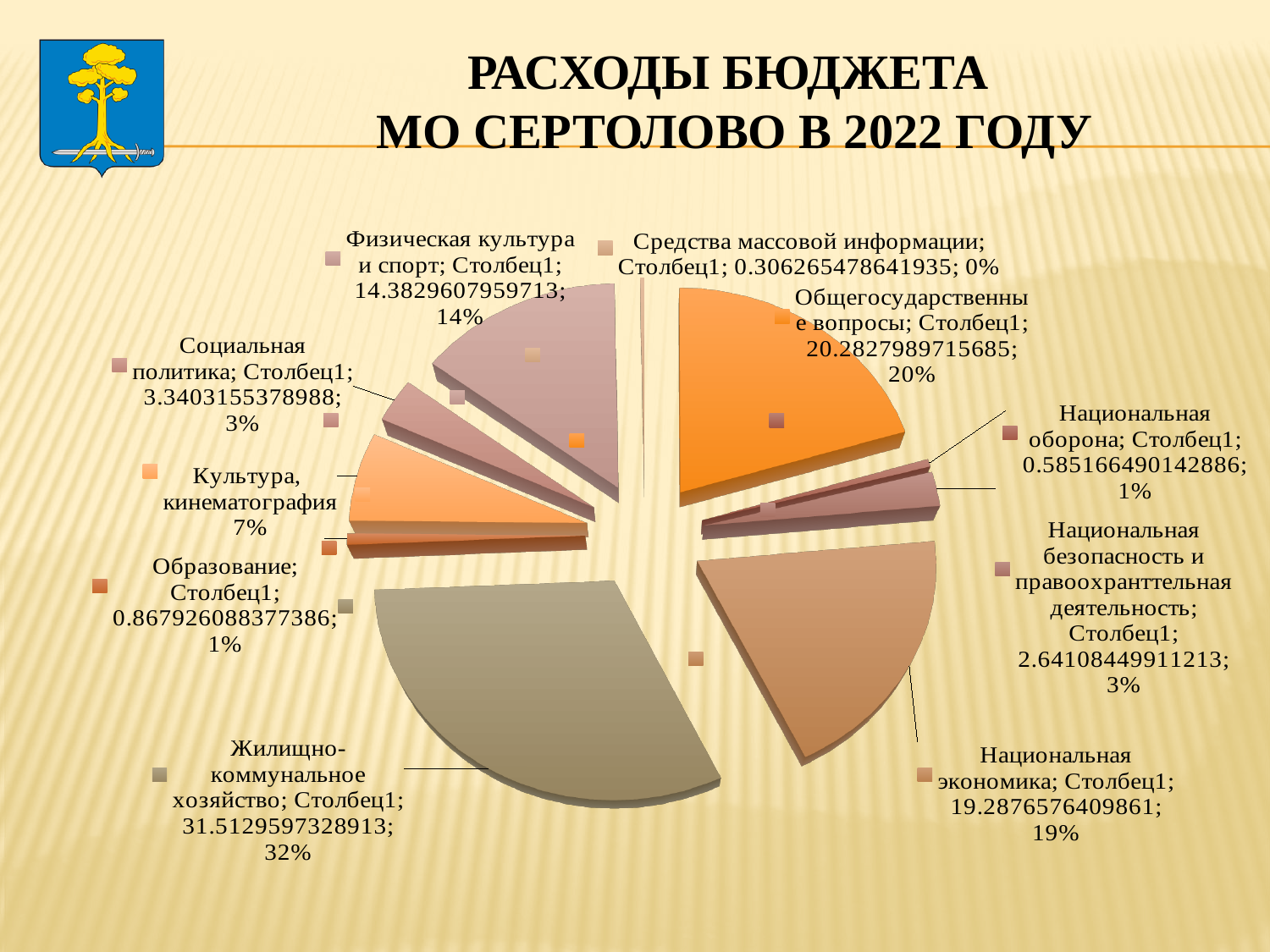
What percentage share does Физическая культура и спорт have in the pie chart? 14% What percentage share does Национальная экономика have in the pie chart? 19% Which category has the smallest share of the pie chart? Средства массовой информации What kind of chart is shown on the slide? pie chart How many categories (slices) does the pie chart show? 10 What percentage share does Культура, кинематография have in the pie chart? 7% Which has a larger share: Общегосударственные вопросы or Физическая культура и спорт? Общегосударственные вопросы Which category has the largest share of the pie chart? Жилищно-коммунальное хозяйство What is the title of the chart on the slide? РАСХОДЫ БЮДЖЕТА МО СЕРТОЛОВО В 2022 ГОДУ What is the value shown for Социальная политика? 3.3403155378988